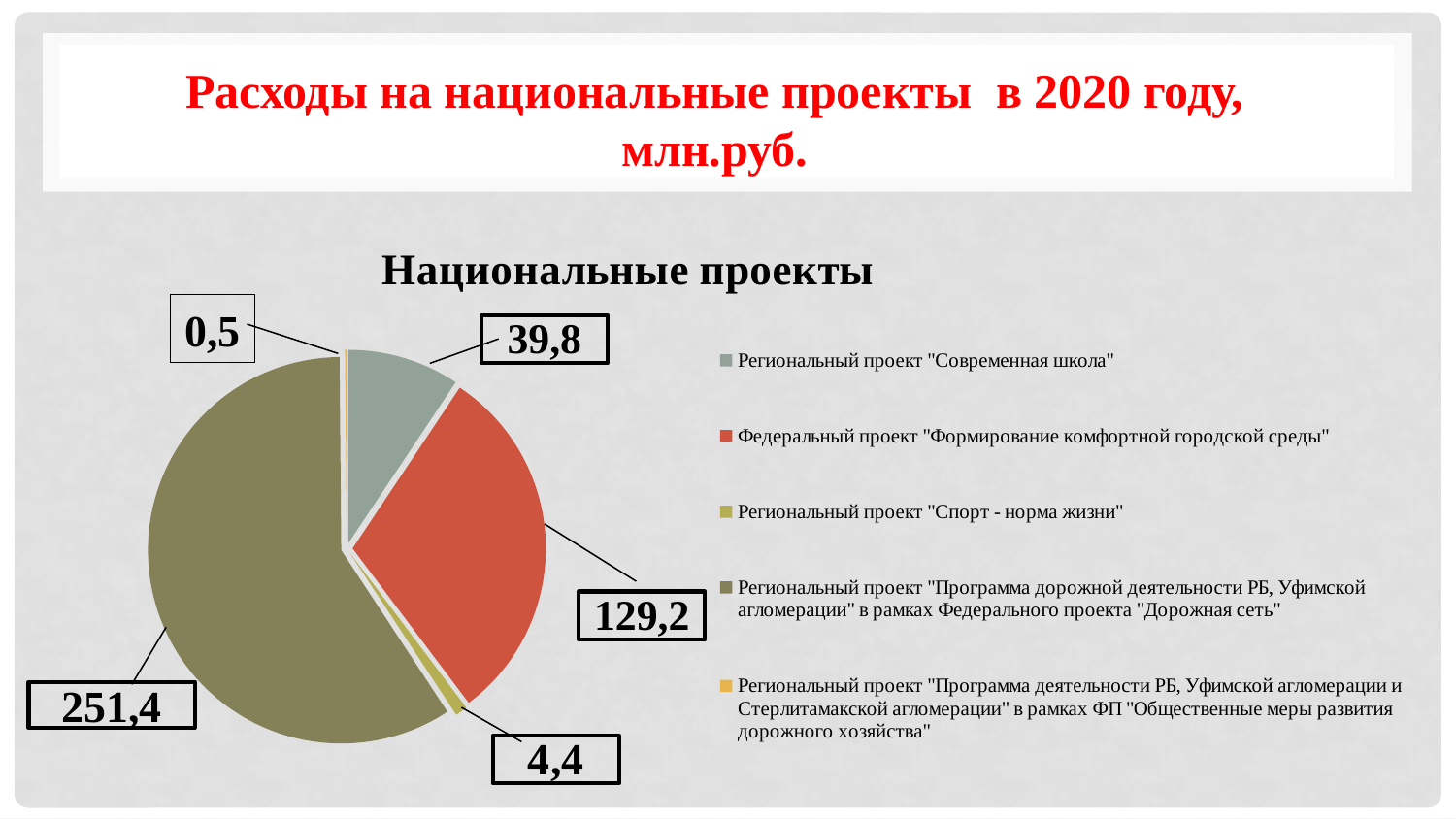
Which is larger: the value for Региональный проект "Спорт - норма жизни" or the value for Региональный проект "Современная школа"? Региональный проект "Современная школа" What is the title of the chart? Национальные проекты What is the value for Региональный проект "Современная школа"? 39,8 What is the smallest value shown on the pie chart? 0,5 What is the value for Федеральный проект "Формирование комфортной городской среды"? 129,2 Which project has the largest slice of the pie? Региональный проект "Программа дорожной деятельности РБ, Уфимской агломерации" в рамках Федерального проекта "Дорожная сеть" How many entries does the legend list? 5 What is the difference between the values for Федеральный проект "Формирование комфортной городской среды" and Региональный проект "Современная школа"? 89,4 What is the value for Региональный проект "Спорт - норма жизни"? 4,4 What type of chart is shown on the slide? pie chart What is the total of all slices in the pie chart? 425,3 How many slices does the pie chart have? 5